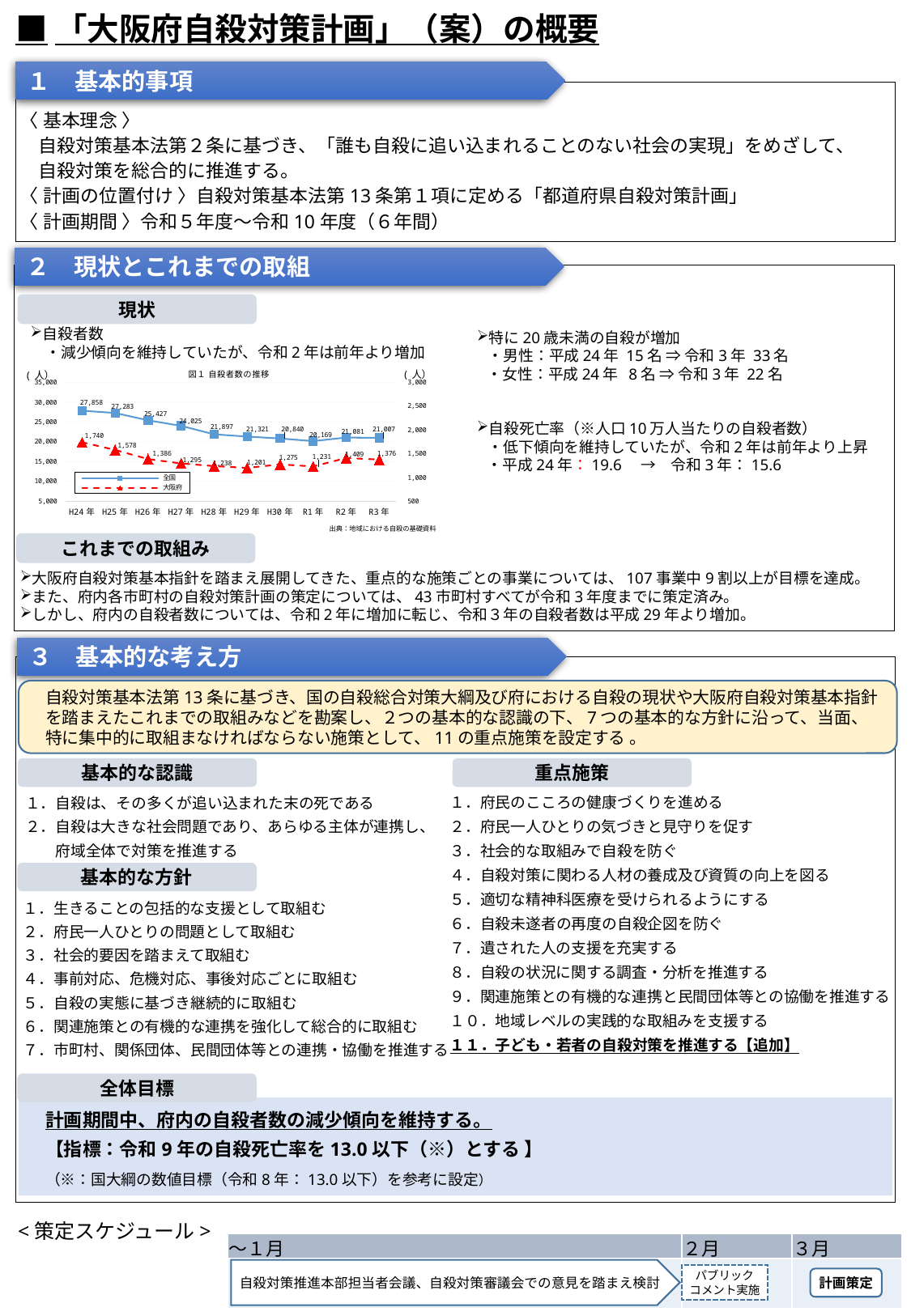
In 図1 自殺者数の推移, does the 全国 series generally rise or fall from H24年 to R1年? fall In 図1 自殺者数の推移, what is the value for 大阪府 in R2年? 1,409 What kind of chart is 図1 自殺者数の推移? line chart In 図1 自殺者数の推移, which is larger for 大阪府: the value in R2年 or the value in R3年? R2年 In 図1 自殺者数の推移, what is the value for 全国 in R3年? 21,007 How many years are plotted on the x axis of 図1 自殺者数の推移? 10 In 図1 自殺者数の推移, which year has the highest value for 全国? H24年 In 図1 自殺者数の推移, what is the value for 大阪府 in H24年? 1,740 How many series does the legend of 図1 自殺者数の推移 list? 2 In 図1 自殺者数の推移, what is the value for 全国 in H24年? 27,858 In 図1 自殺者数の推移, what is the difference between the 全国 values for H24年 and H25年? 575 In 図1 自殺者数の推移, which year has the lowest value for 全国? R1年